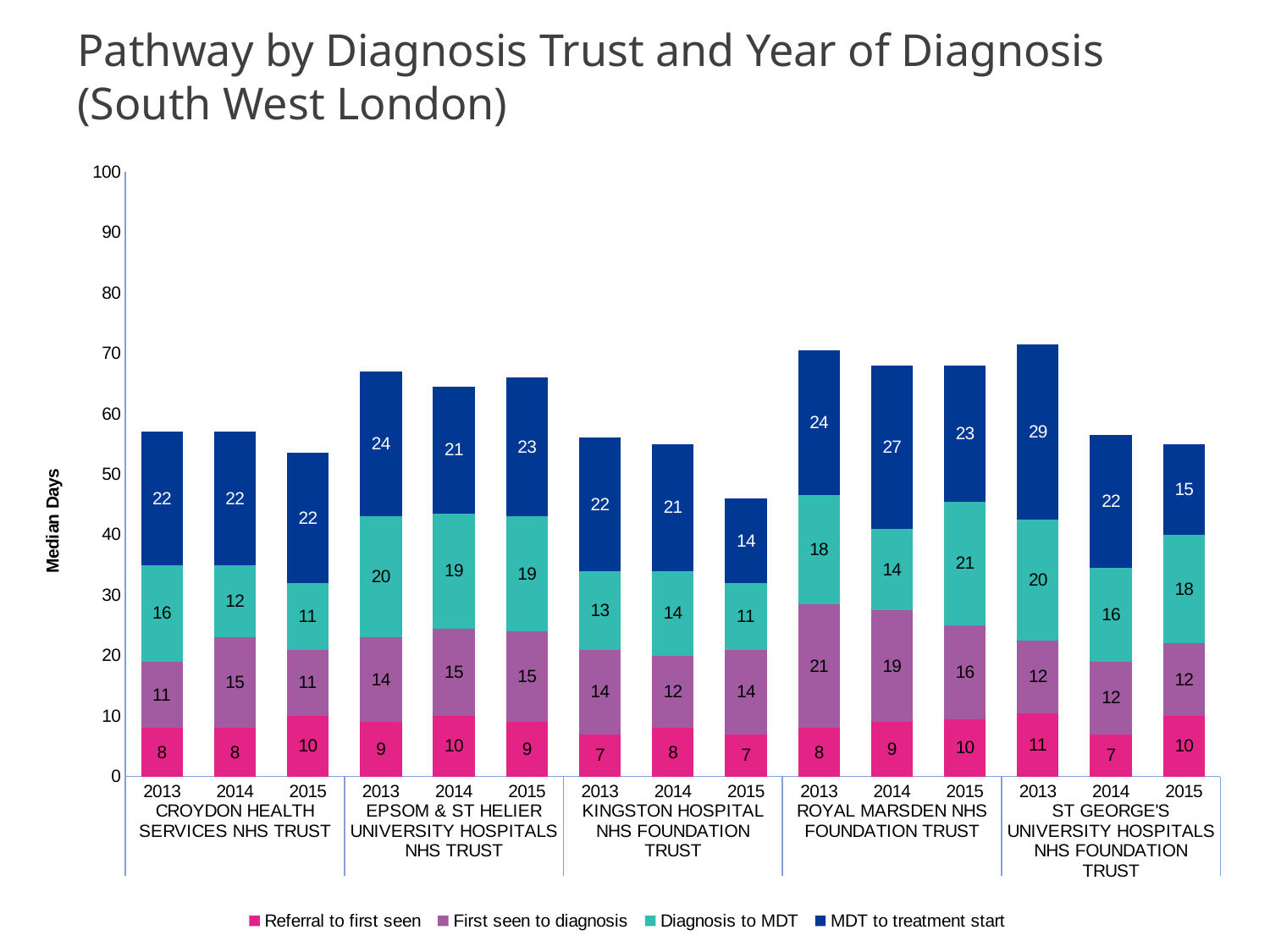
What is the value for First seen to diagnosis at Epsom & St Helier University Hospitals NHS Trust in 2014? 15 Which trust and year has the lowest total median days? Kingston Hospital NHS Foundation Trust, 2015 How many series does the legend list? 4 What is the value for Referral to first seen at Kingston Hospital NHS Foundation Trust in 2014? 8 What kind of chart is shown on the slide? Stacked bar chart Which series is shown in dark blue in the legend? MDT to treatment start What is the difference between the MDT to treatment start values for Royal Marsden NHS Foundation Trust in 2014 and 2015? 4 What is the value for MDT to treatment start at St George's University Hospitals NHS Foundation Trust in 2013? 29 What is the value for Diagnosis to MDT at Royal Marsden NHS Foundation Trust in 2015? 21 What is the total median days for the stacked bar for Kingston Hospital NHS Foundation Trust in 2015? 46 Which is larger: the Diagnosis to MDT value for Croydon Health Services NHS Trust in 2013 or in 2015? 2013 What is the total median days for the stacked bar for Croydon Health Services NHS Trust in 2013? 57